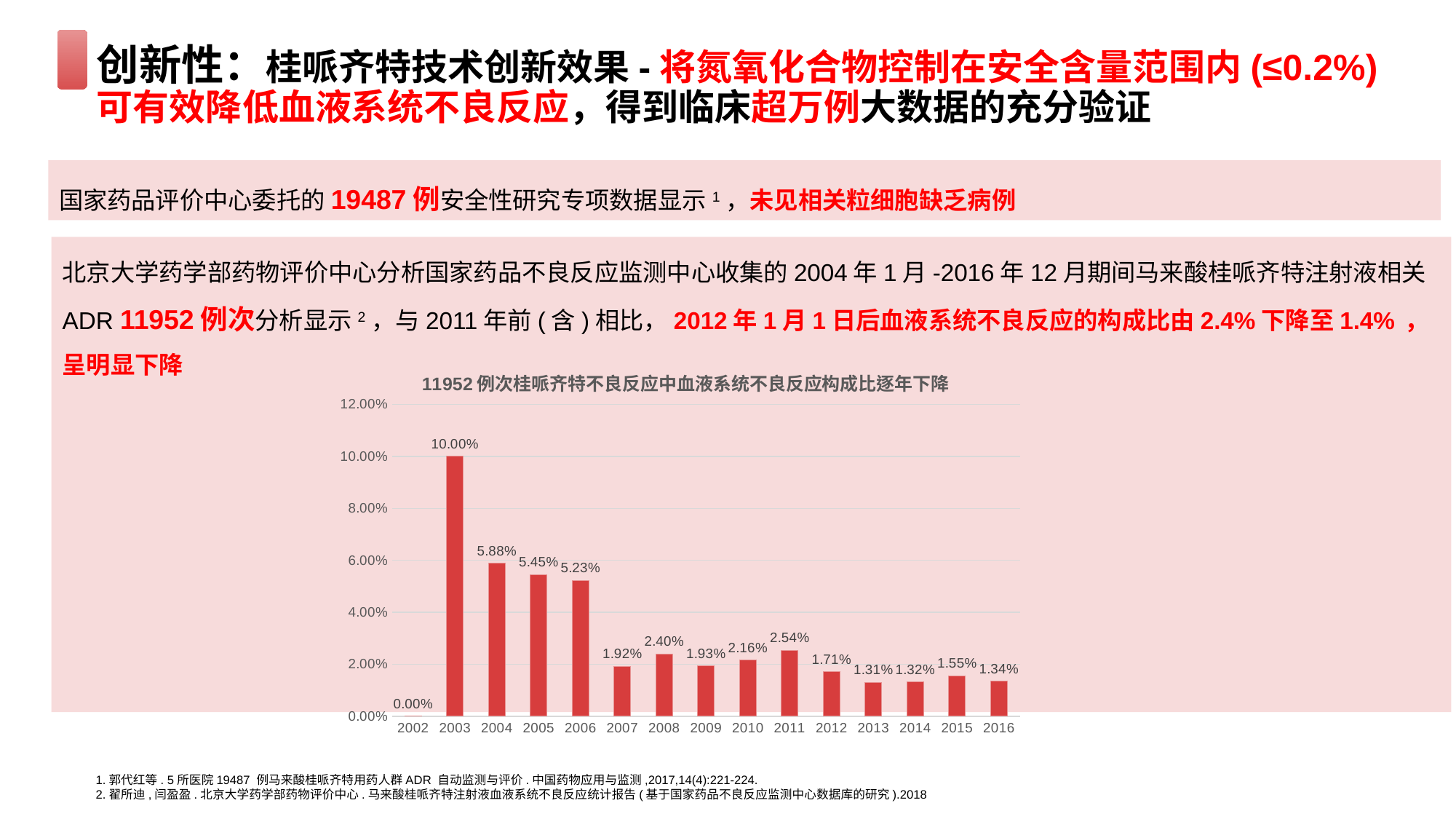
What type of chart is shown on the slide? Bar chart Which year has the highest value in the chart? 2003 What is the value for 2016 in the chart? 1.34% What is the difference between the values for 2003 and 2004? 4.12% Which year has the larger value, 2008 or 2009? 2008 Overall, do the values rise or fall from 2003 to 2016? Fall What is the value for 2003 in the chart? 10.00% What is the difference between the values for 2011 and 2012? 0.83% What is the value for 2011 in the chart? 2.54% Which year has the lowest value in the chart? 2002 How many years are shown on the x axis of the chart? 15 What is the value for 2008 in the chart? 2.40%